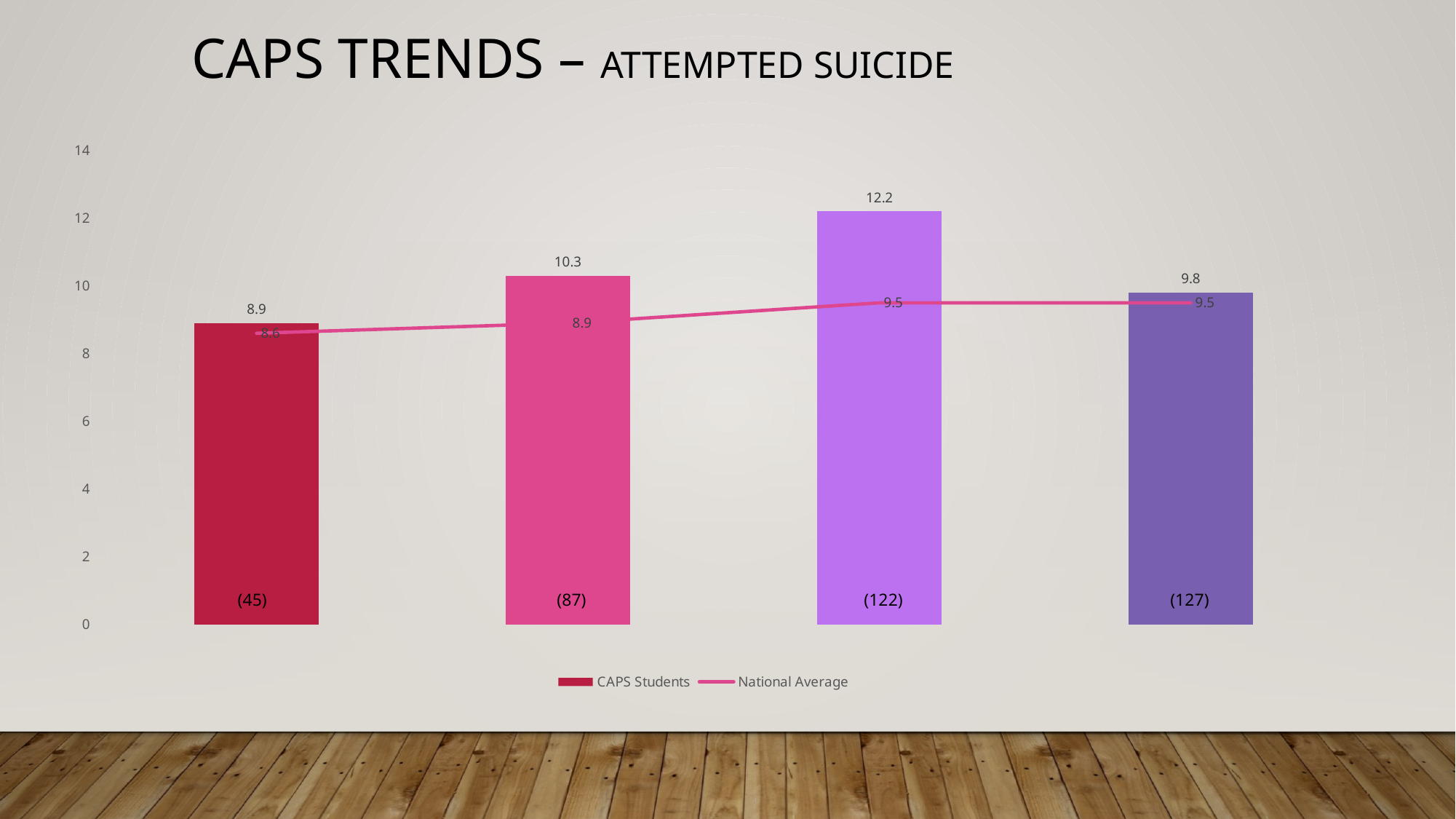
What number is printed in parentheses at the bottom of the fourth (rightmost) bar? (127) What is the CAPS Students value for the third bar? 12.2 What is the National Average value at the fourth (rightmost) point? 9.5 What is the difference between the CAPS Students value of the third bar and the National Average at the same point? 2.7 Which bar has the lowest CAPS Students value? The first bar (8.9) Which bar has the highest CAPS Students value? The third bar (12.2) What is the CAPS Students value for the first (leftmost) bar? 8.9 Is the CAPS Students value for the second bar larger or smaller than the National Average at that point? Larger How many bars are plotted in the chart? 4 How many series does the legend list? 2 What type of chart is shown on the slide? Bar chart with a line What is the National Average value at the first (leftmost) point? 8.6